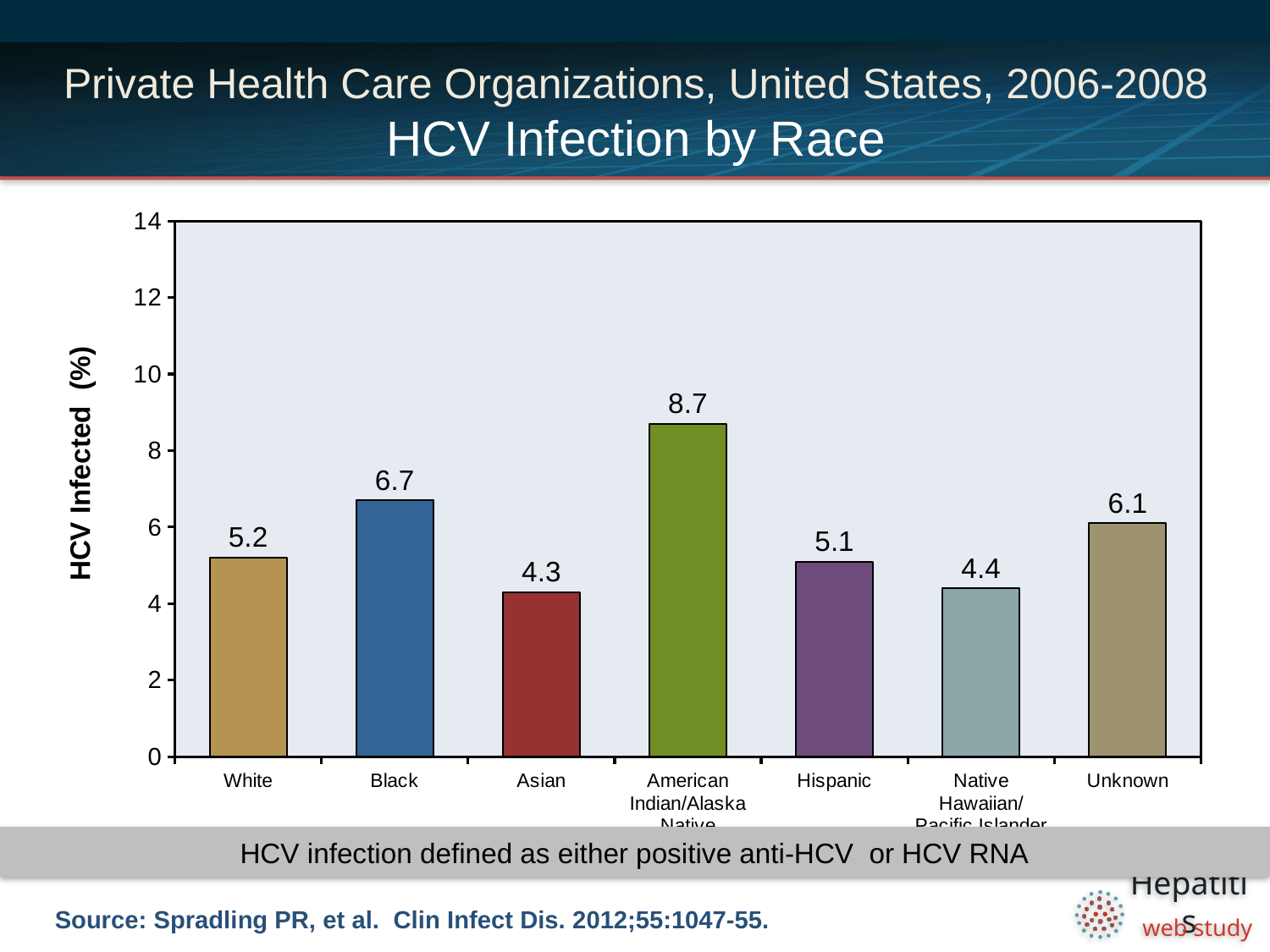
What is the HCV infected percentage for Black? 6.7 What is the difference between the HCV infected percentage for American Indian/Alaska Native and Asian? 4.4 Which race category has the highest HCV infected percentage? American Indian/Alaska Native What is the difference between the HCV infected percentage for Black and White? 1.5 What is the HCV infected percentage for White? 5.2 Which has a higher HCV infected percentage, Black or Unknown? Black Is the value for American Indian/Alaska Native greater or less than 8? greater What is the HCV infected percentage for Unknown? 6.1 Which race category has the lowest HCV infected percentage? Asian What kind of chart is shown on the slide? Bar chart How many race categories are shown in the chart? 7 What is the HCV infected percentage for Hispanic? 5.1